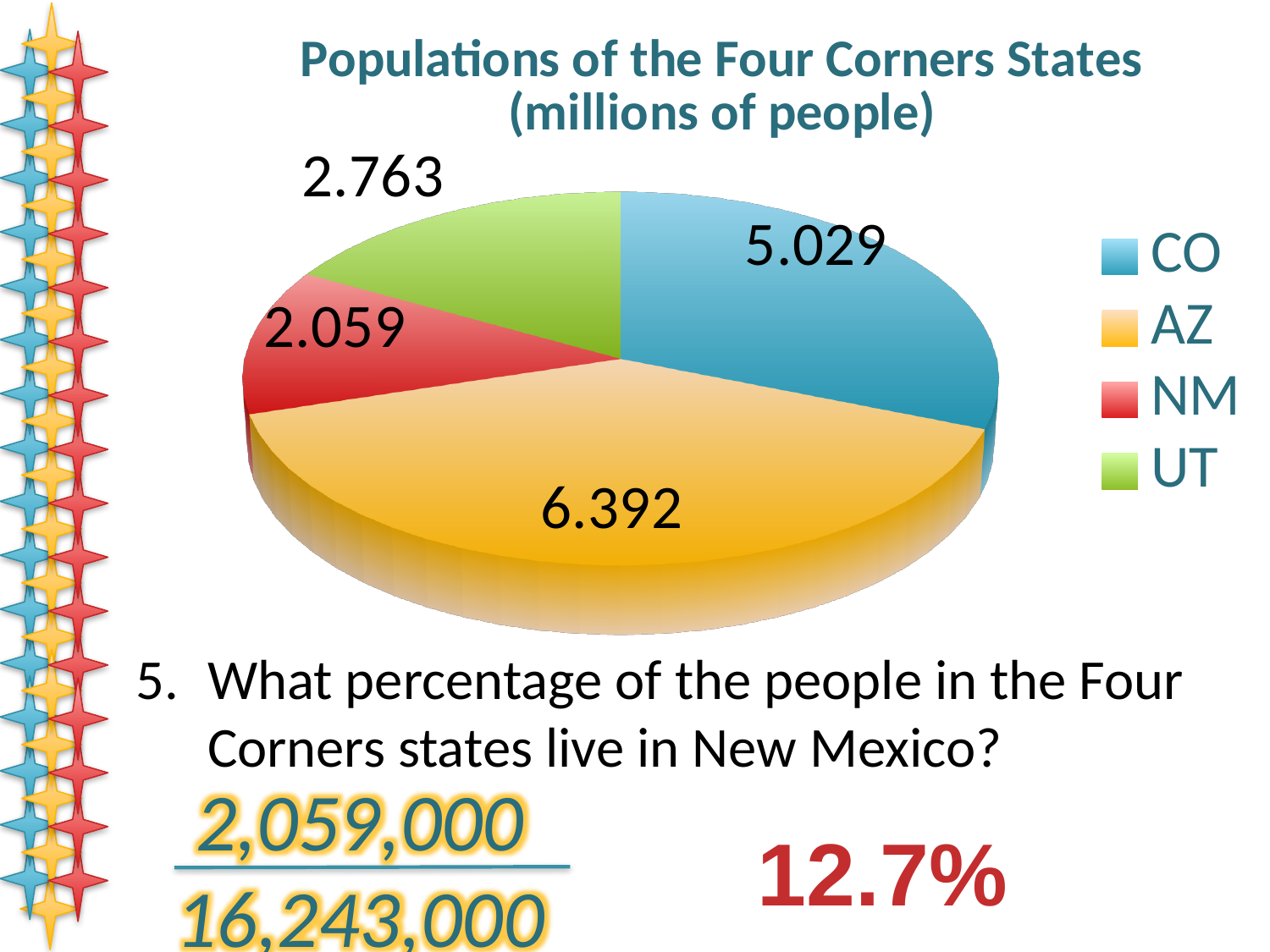
Which state has the smallest slice of the pie? NM What is the difference between the values for AZ and CO? 1.363 Which state has the largest slice of the pie? AZ What is the population value shown for AZ? 6.392 How many states are shown in the pie chart? 4 Which is larger, the value for CO or the value for UT? CO What is the population value shown for UT? 2.763 What percentage of the total do the people in NM represent? 12.7% What is the difference between the values for UT and NM? 0.704 What is the population value shown for NM? 2.059 What kind of chart is shown on the slide? Pie chart What is the title of the chart? Populations of the Four Corners States (millions of people)